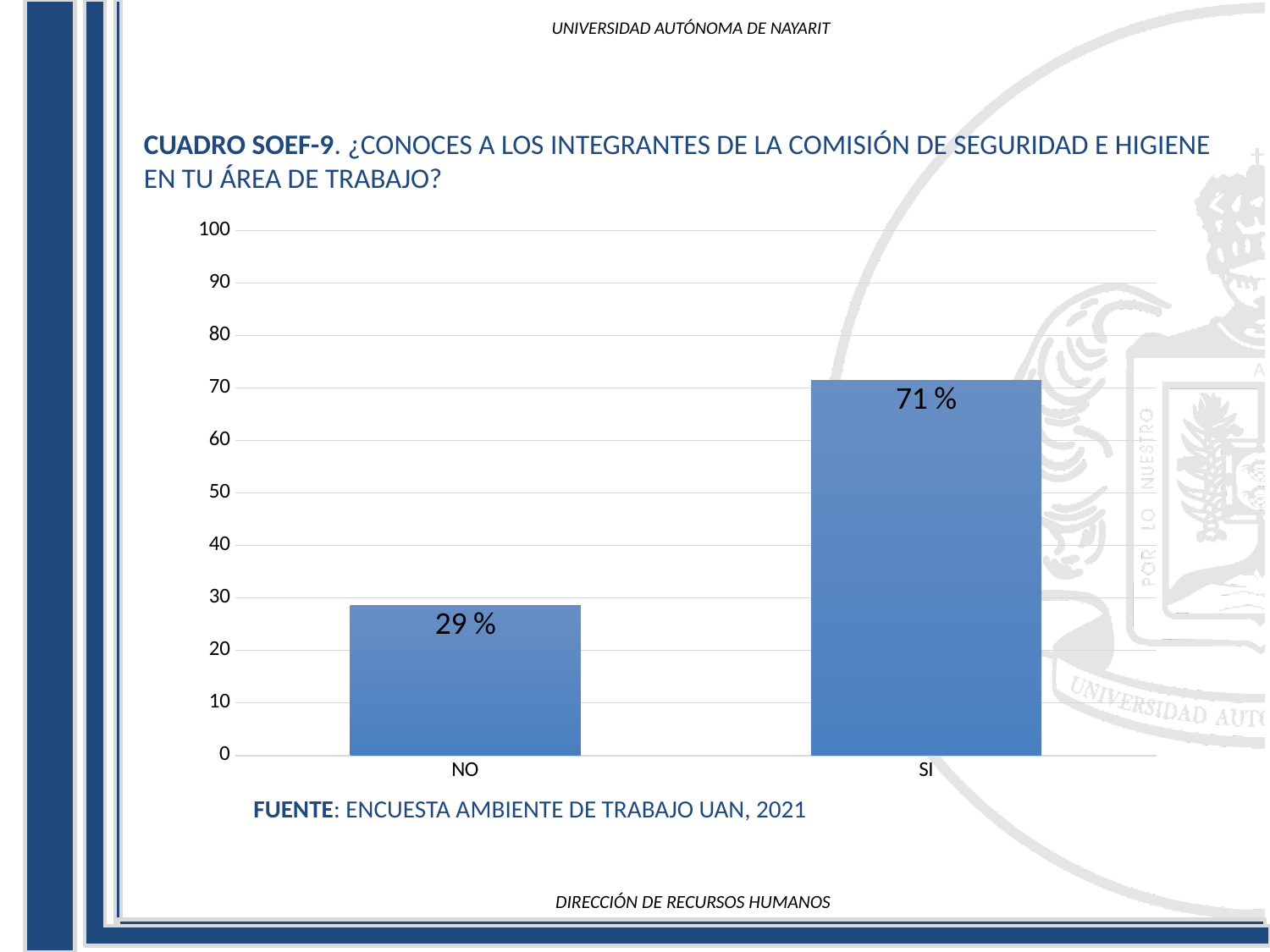
What kind of chart is shown on the slide? bar chart Which category has the highest value? SI What is the value for NO? 29 % Is the value for SI greater or less than 60? greater What is the maximum value shown on the y axis? 100 Is the value for NO greater or less than 40? less What is the source cited below the chart? ENCUESTA AMBIENTE DE TRABAJO UAN, 2021 What is the value for SI? 71 % Which category has the lowest value? NO How many categories are shown on the x axis? 2 Which is larger, the value for NO or the value for SI? SI What is the difference between the values for SI and NO? 42 %